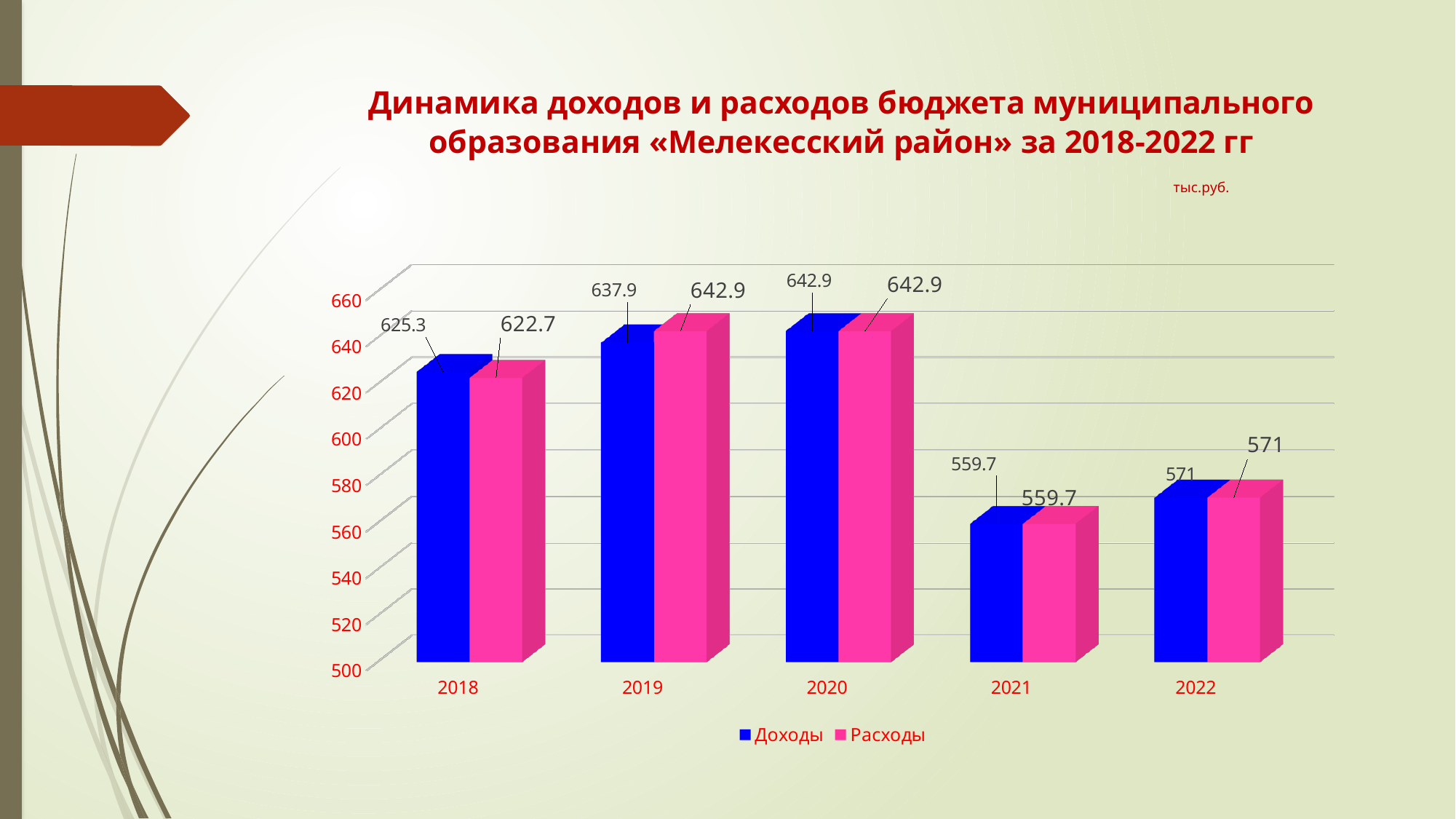
What kind of chart is shown on the slide? Bar chart In which year is Расходы the lowest? 2021 What is the difference between Доходы in 2020 and Доходы in 2021? 83.2 How many years are shown on the x axis? 5 How many series does the legend list? 2 What is the value of Доходы for 2018? 625.3 In which year is Доходы the highest? 2020 What is the value of Расходы for 2022? 571 Which is larger in 2018, Доходы or Расходы? Доходы What is the difference between Доходы and Расходы in 2019? 5 What is the value of Доходы for 2021? 559.7 What is the value of Расходы for 2019? 642.9